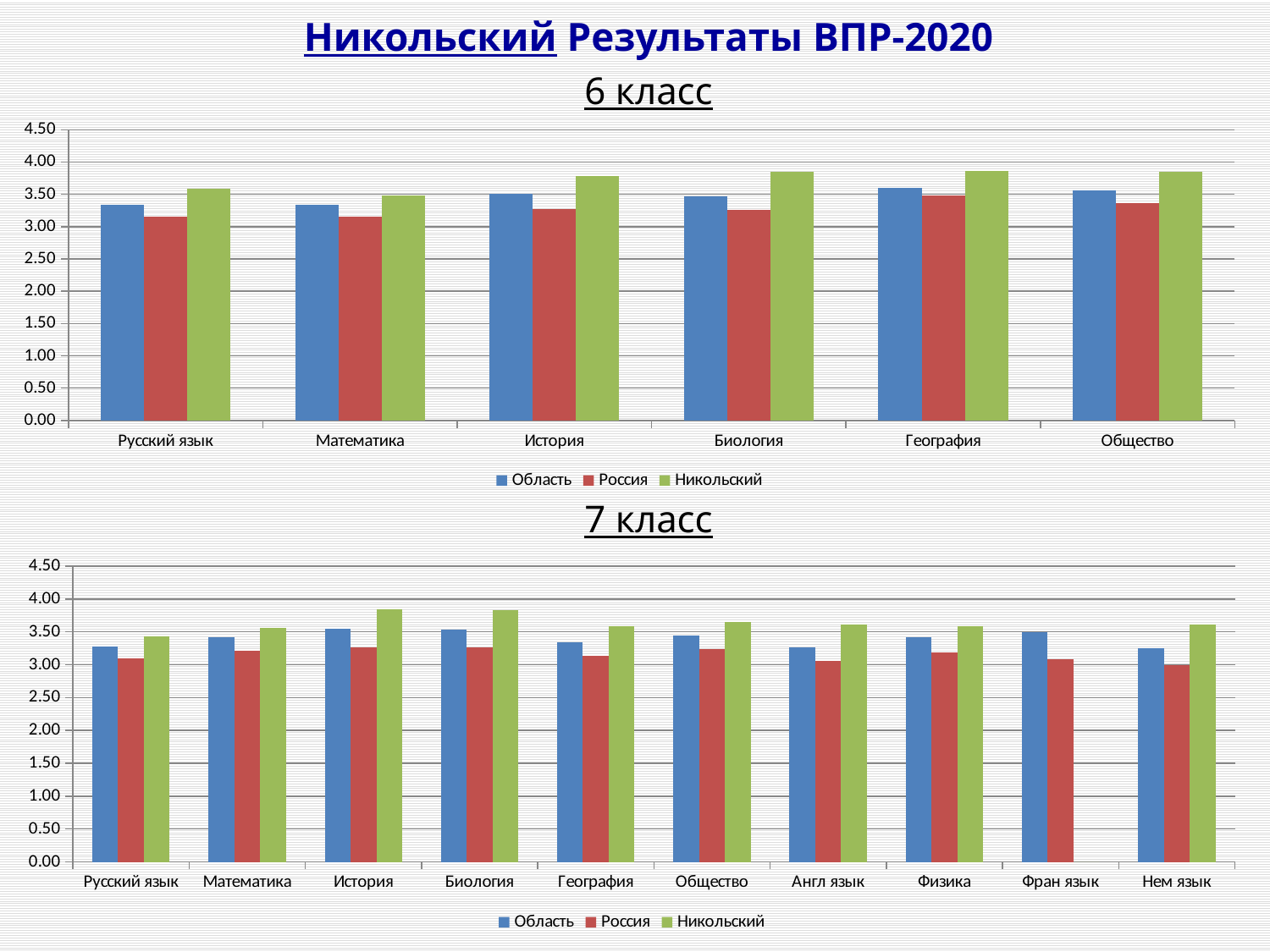
In the "7 класс" chart, which series is shown in green? Никольский In the "6 класс" chart, is the value of Никольский for Биология greater or less than 3.50? greater In the "7 класс" chart, is the value of Никольский for История greater or less than 3.50? greater How many subjects are shown on the x axis of the "6 класс" chart? 6 What kind of chart is the "6 класс" chart? bar chart In the "6 класс" chart, which series has the lowest value for Русский язык? Россия How many series does the legend of the "7 класс" chart list? 3 How many subjects are shown on the x axis of the "7 класс" chart? 10 In the "6 класс" chart, which series has the highest value for Биология? Никольский In the "7 класс" chart, which is larger for Русский язык: Область or Россия? Область In the "6 класс" chart, is the value of Россия for Математика greater or less than 3.50? less How many series does the legend of the "6 класс" chart list? 3